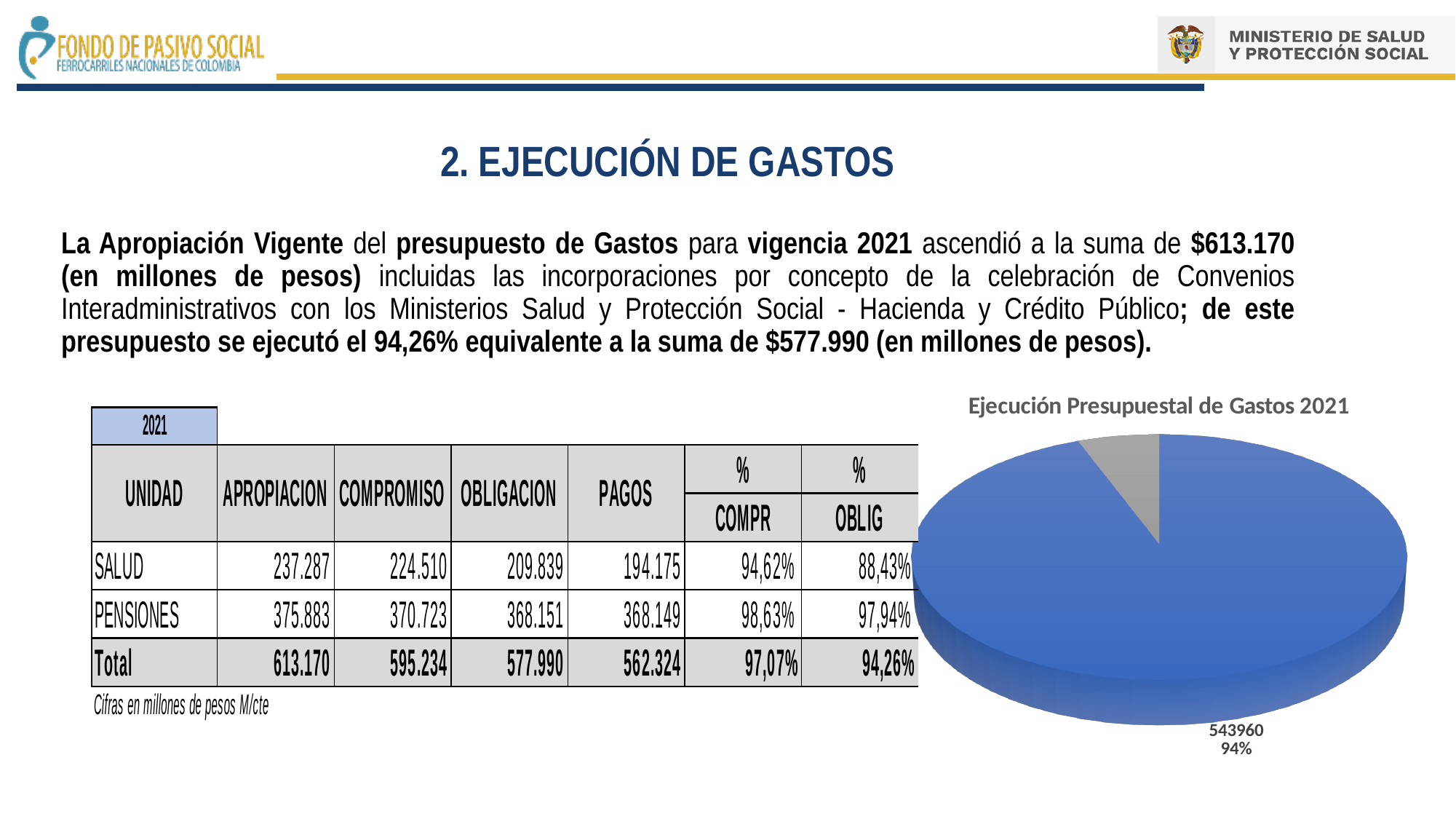
What percentage share is printed for the large blue slice of the pie chart? 94% What kind of chart is shown on the slide? pie chart Which slice of the pie chart is larger, the blue one or the grey one? the blue one What is the title of the pie chart? Ejecución Presupuestal de Gastos 2021 What colour is the largest slice of the pie chart? blue How many slices does the pie chart have? 2 What value is printed on the data label of the large blue slice of the pie chart? 543960